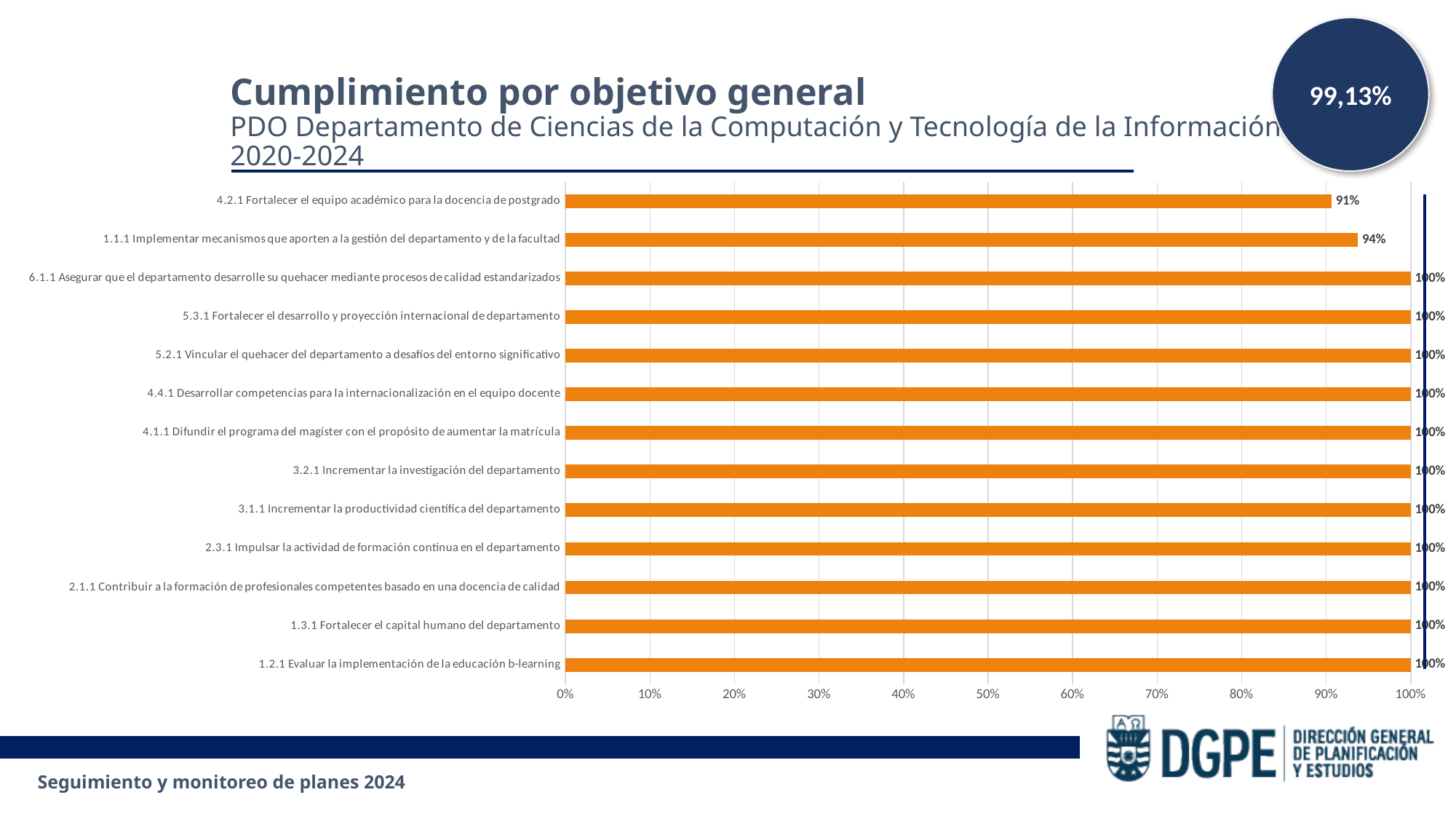
Which is larger, the value for 4.2.1 Fortalecer el equipo académico para la docencia de postgrado or the value for 1.2.1 Evaluar la implementación de la educación b-learning? 1.2.1 Evaluar la implementación de la educación b-learning What overall percentage is shown in the circle at the top right of the slide? 99,13% What is the value for 3.2.1 Incrementar la investigación del departamento? 100% What is the value for 1.1.1 Implementar mecanismos que aporten a la gestión del departamento y de la facultad? 94% Which objective has the lowest value? 4.2.1 Fortalecer el equipo académico para la docencia de postgrado How many objectives are shown in the chart? 13 How many objectives have a value of 100%? 11 What is the difference between the values for 1.1.1 Implementar mecanismos que aporten a la gestión del departamento y de la facultad and 4.2.1 Fortalecer el equipo académico para la docencia de postgrado? 3% Is the value for 4.2.1 Fortalecer el equipo académico para la docencia de postgrado greater or less than 80%? greater What is the title of the slide? Cumplimiento por objetivo general What is the value for 4.2.1 Fortalecer el equipo académico para la docencia de postgrado? 91% What kind of chart is shown on the slide? bar chart